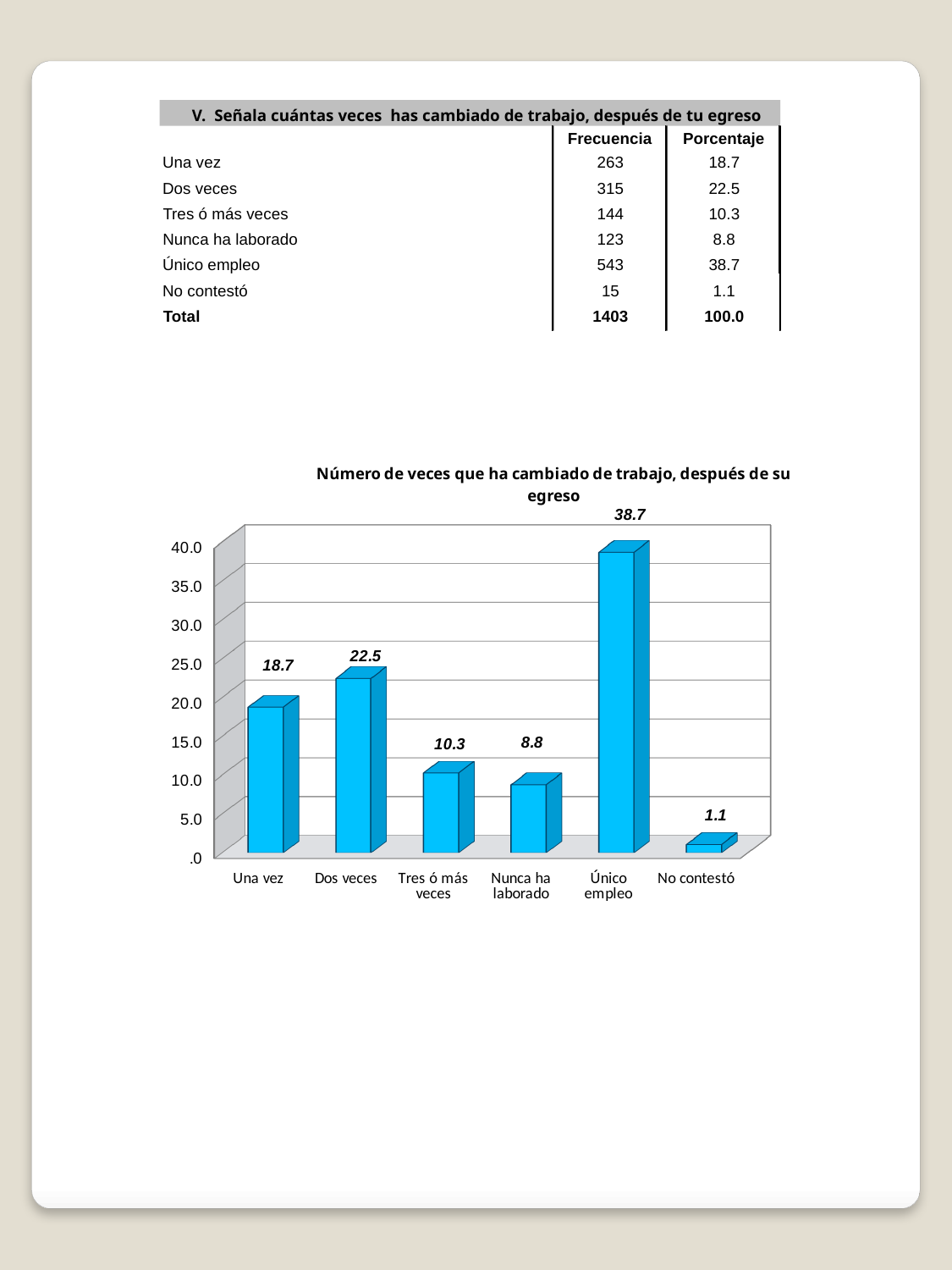
How many categories are shown on the x axis? 6 What is the value for Único empleo? 38.7 What is the difference between the values for Una vez and Nunca ha laborado? 9.9 What is the title of the chart? Número de veces que ha cambiado de trabajo, después de su egreso Is the value for Una vez greater or less than 20.0? less What kind of chart is shown? bar chart What is the difference between the values for Único empleo and Dos veces? 16.2 Which category has the lowest value? No contestó What is the value for Dos veces? 22.5 Which is larger, the value for Tres ó más veces or the value for Nunca ha laborado? Tres ó más veces What is the value for No contestó? 1.1 Which category has the highest value? Único empleo